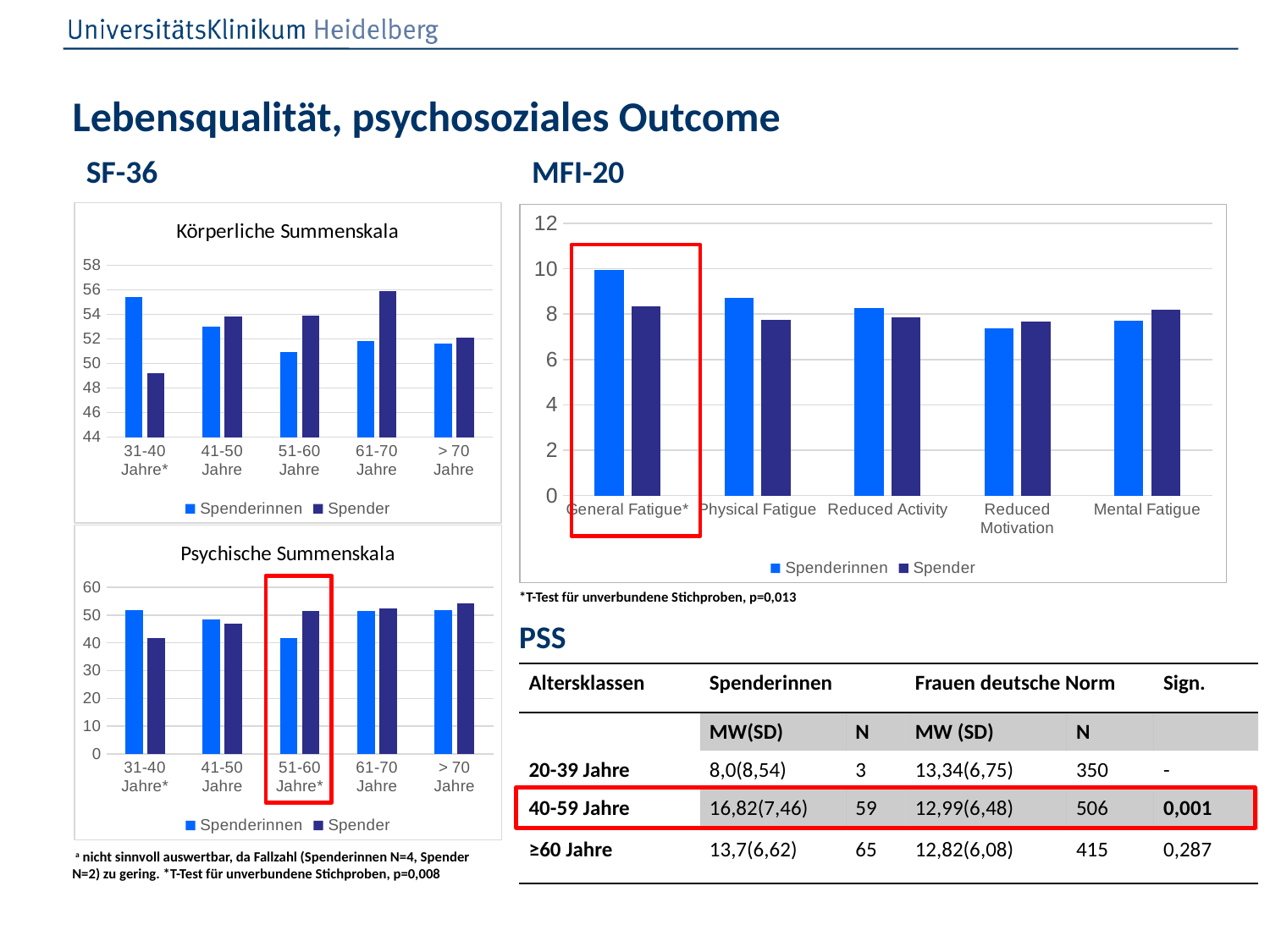
In the Körperliche Summenskala chart, is the value for Spender in the 31-40 Jahre* category greater or less than 50? less In the MFI-20 chart, which category has the highest Spenderinnen value? General Fatigue* In the Körperliche Summenskala chart, which age category has the highest Spender value? 61-70 Jahre In the Psychische Summenskala chart, is the value for Spenderinnen in the 51-60 Jahre* category greater or less than 50? less In the MFI-20 chart, how many series does the legend list? 2 What type of chart is the Psychische Summenskala chart? bar chart In the Körperliche Summenskala chart, how many age categories are shown on the x axis? 5 In the MFI-20 chart, how many categories are shown on the x axis? 5 In the Körperliche Summenskala chart, which series has the larger value in the 31-40 Jahre* category, Spenderinnen or Spender? Spenderinnen In the MFI-20 chart, is the value for Spenderinnen in General Fatigue* greater or less than 8? greater In the Psychische Summenskala chart, which series has the larger value in the 51-60 Jahre* category, Spenderinnen or Spender? Spender In the Psychische Summenskala chart, which age category has the lowest Spenderinnen value? 51-60 Jahre*